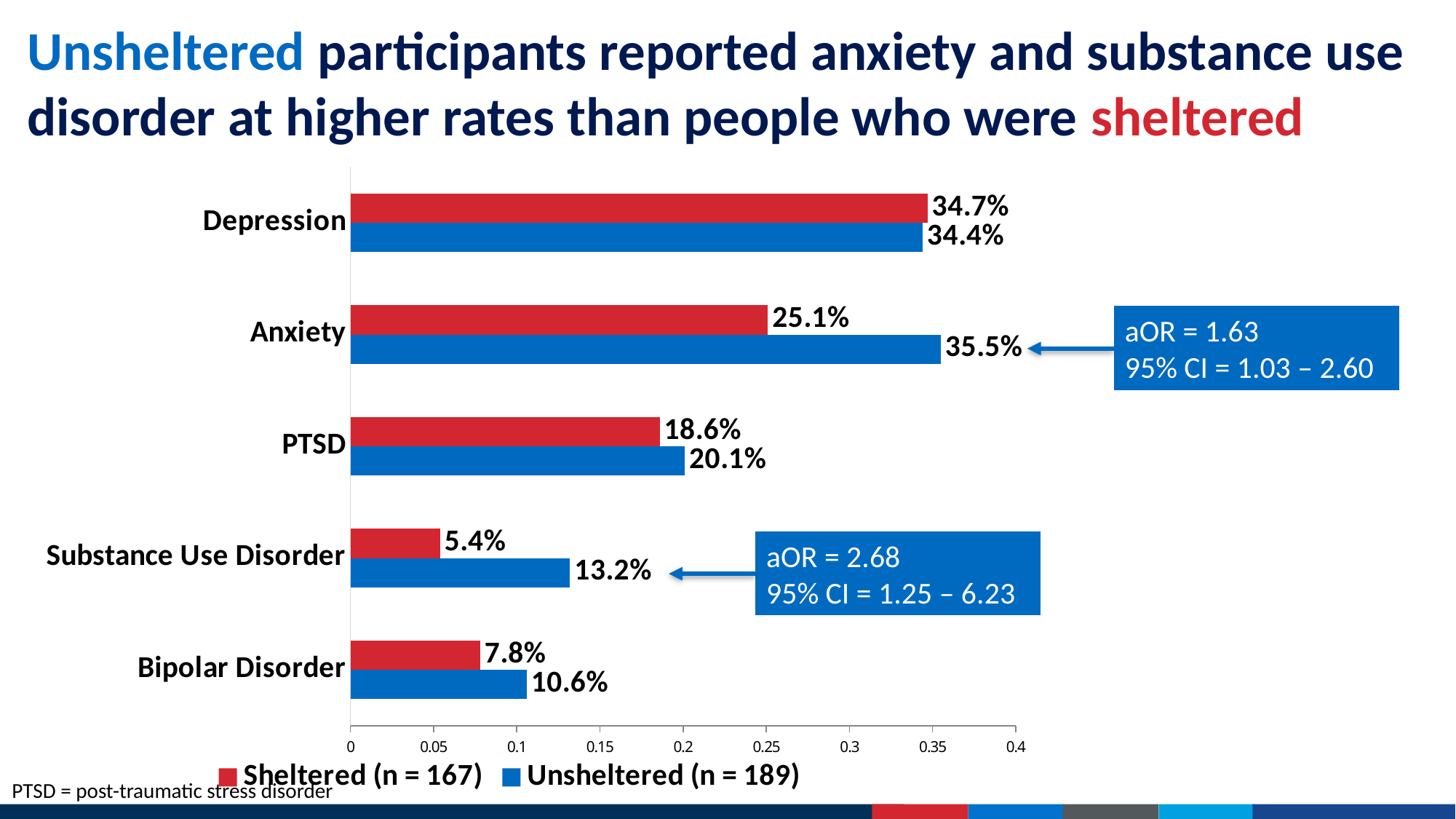
How many conditions are shown on the chart? 5 What type of chart is shown on the slide? Bar chart What percentage of unsheltered participants reported anxiety? 35.5% What is the difference between the unsheltered and sheltered rates for anxiety? 10.4% For PTSD, which group has the higher rate, sheltered or unsheltered? Unsheltered Which condition has the lowest rate among sheltered participants? Substance Use Disorder What percentage of sheltered participants reported substance use disorder? 5.4% What percentage of sheltered participants reported depression? 34.7% Which condition has the highest rate among unsheltered participants? Anxiety What percentage of unsheltered participants reported bipolar disorder? 10.6% What is the difference between the unsheltered and sheltered rates for substance use disorder? 7.8% How many series does the legend list? 2